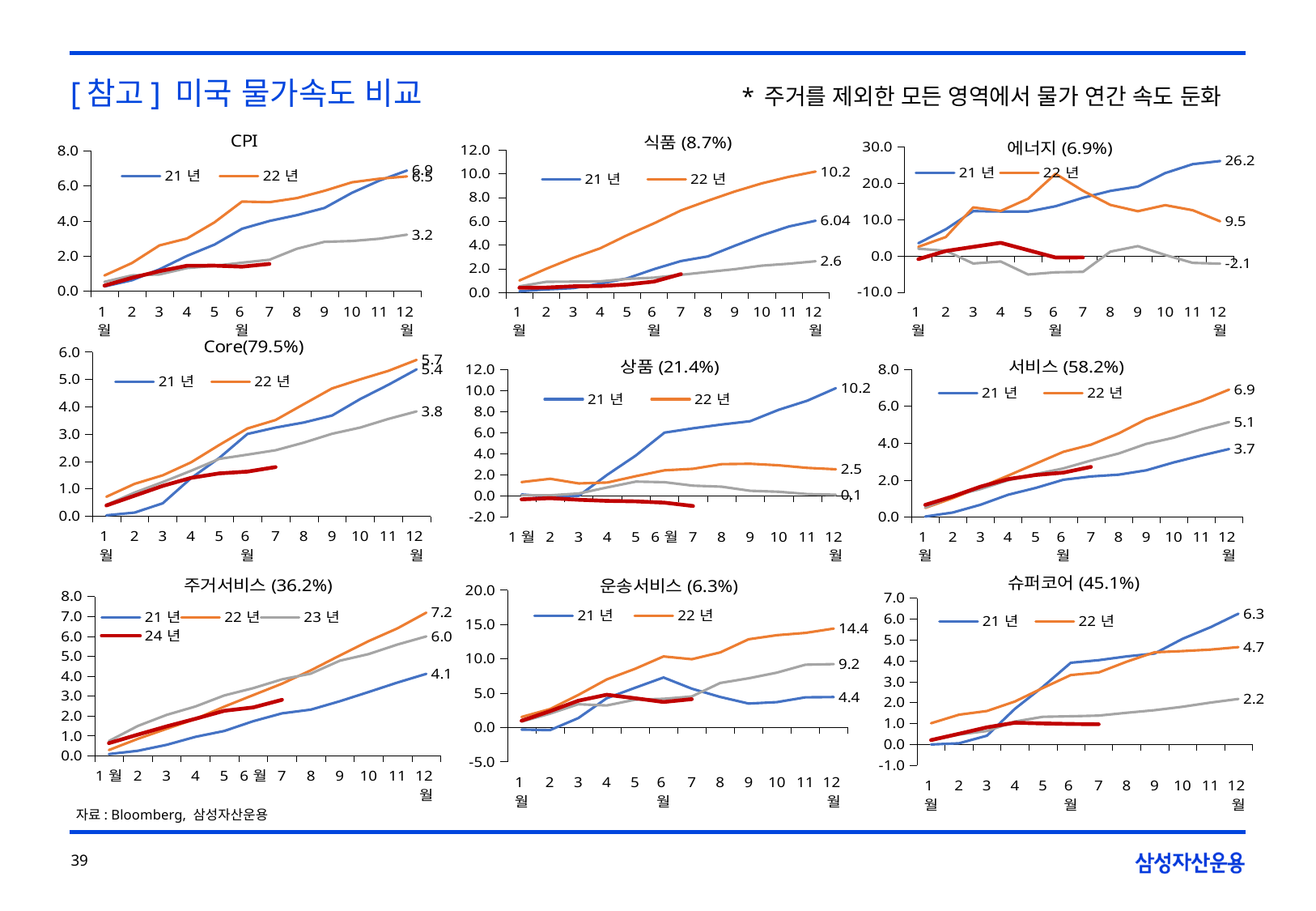
In the 주거서비스 (36.2%) chart, how many series does the legend list? 4 What kind of chart is the 주거서비스 (36.2%) chart? Line chart In the 운송서비스 (6.3%) chart, what is the difference between the December labels of the 22 년 line (14.4) and the 21 년 line (4.4)? 10.0 In the 식품 (8.7%) chart, what is the December value labeled for the 22 년 line? 10.2 In the 에너지 (6.9%) chart, which line ends higher in December, 21 년 or 22 년? 21 년 In the 상품 (21.4%) chart, what is the December value labeled for the 22 년 line? 2.5 In the Core(79.5%) chart, what is the difference between the December labels of the 22 년 line (5.7) and the 21 년 line (5.4)? 0.3 In the 슈퍼코어 (45.1%) chart, what is the December value labeled for the 21 년 line? 6.3 In the 상품 (21.4%) chart, is the December value of the 21 년 line greater or less than 8.0? greater In the 서비스 (58.2%) chart, which line ends higher in December, 21 년 or 22 년? 22 년 How many charts are shown on the slide? 9 In the 에너지 (6.9%) chart, what is the December value labeled for the 21 년 line? 26.2